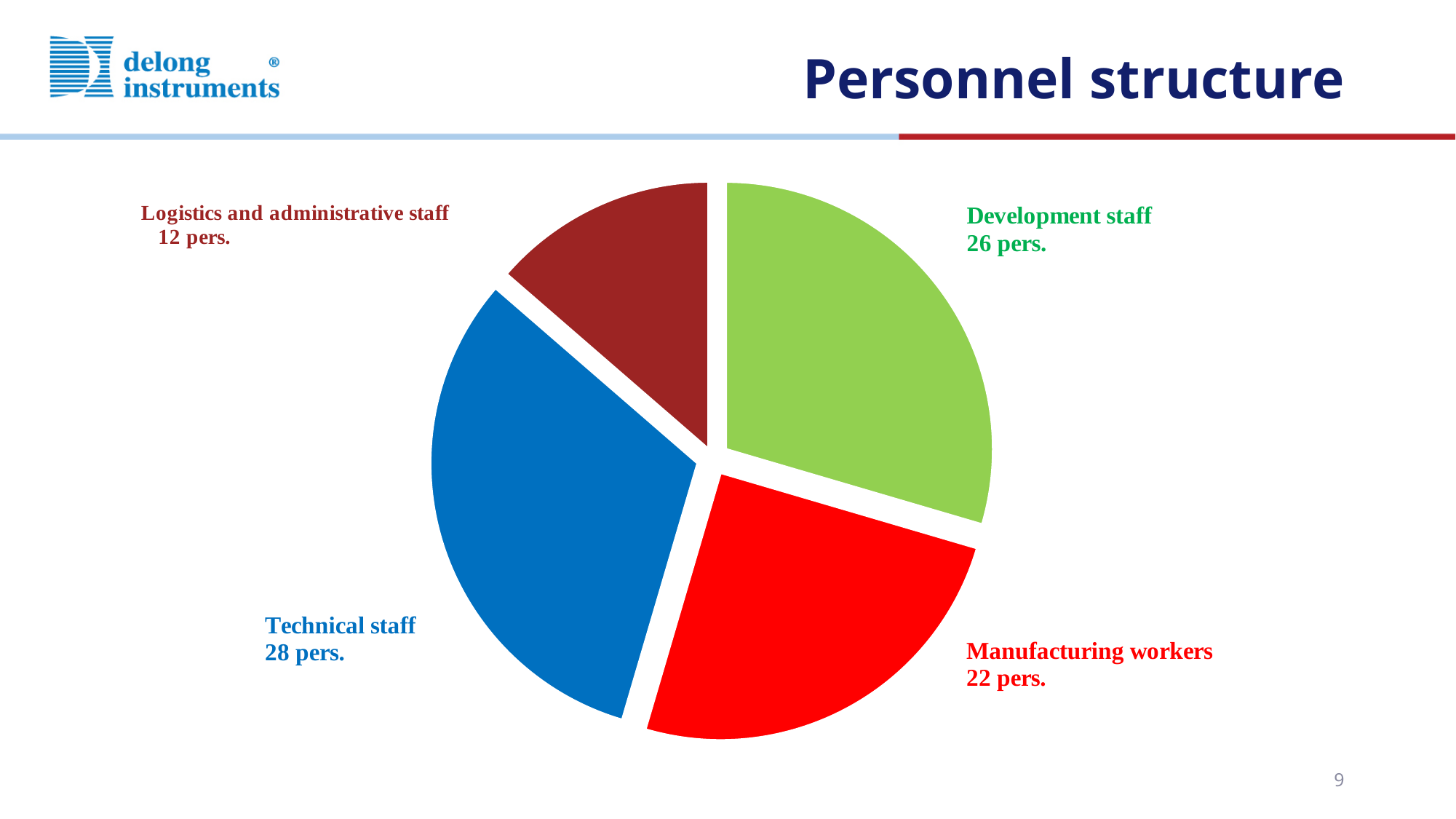
What is the value for Logistics and administrative staff? 12 pers. What is the difference in persons between Technical staff and Logistics and administrative staff? 16 pers. What is the value shown for Technical staff? 28 pers. How many persons are Manufacturing workers according to the chart? 22 pers. Which category has the smallest slice of the pie? Logistics and administrative staff What share of the total personnel do Manufacturing workers represent? 25% How many persons are in the Development staff slice? 26 pers. How many categories does the pie chart show? 4 What kind of chart is shown on the slide? Pie chart Which category has the largest slice of the pie? Technical staff Which is larger, Development staff or Manufacturing workers? Development staff What is the total number of persons across all slices of the pie? 88 pers.